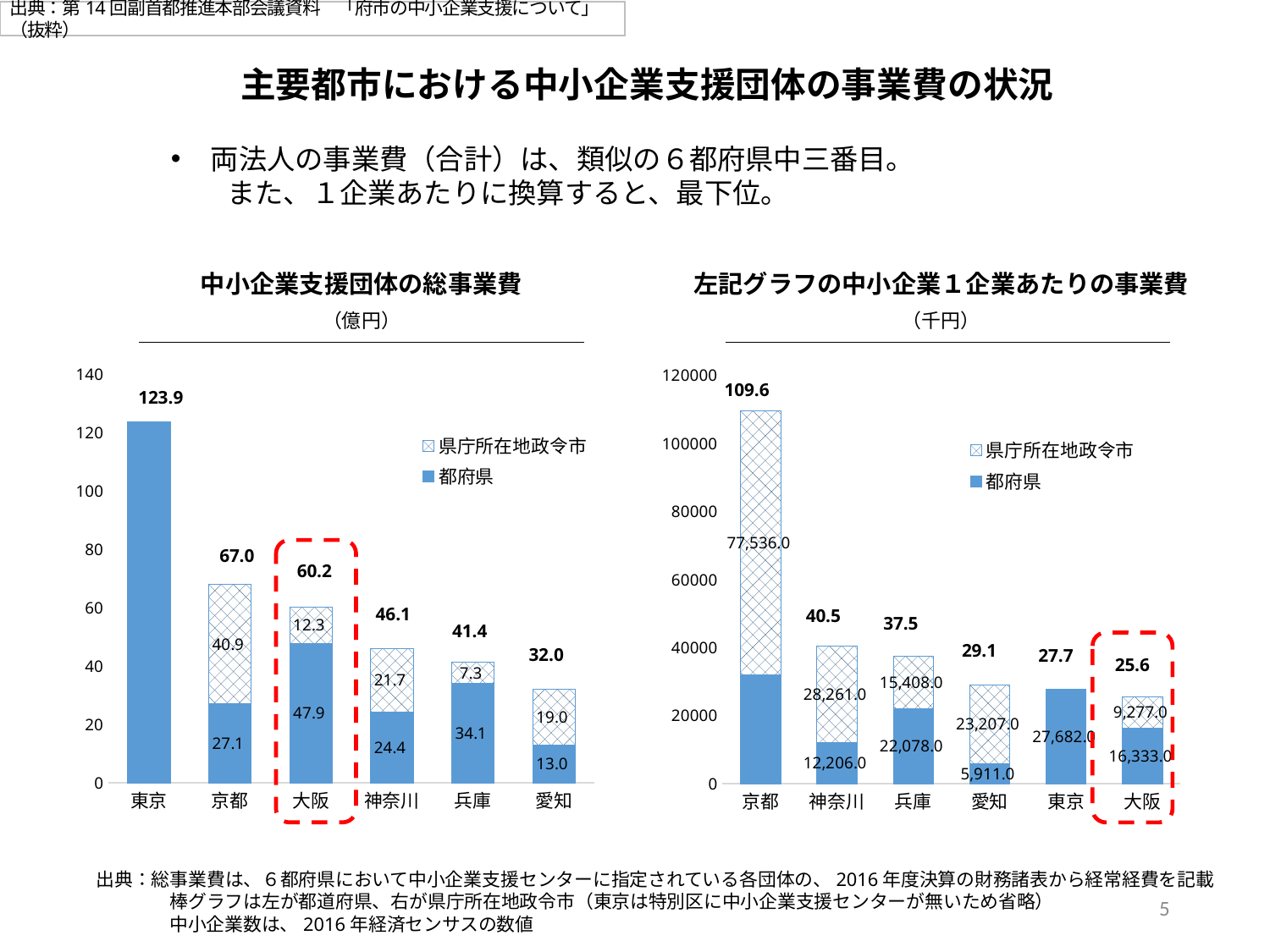
In the left chart (中小企業支援団体の総事業費), what is the difference between the totals for 京都 and 大阪? 6.8 In the left chart (中小企業支援団体の総事業費), what is the total value labeled for 東京? 123.9 In the right chart (左記グラフの中小企業１企業あたりの事業費), what is the 県庁所在地政令市 value for 京都? 77,536.0 In the left chart (中小企業支援団体の総事業費), which category has the lowest total? 愛知 In the left chart (中小企業支援団体の総事業費), what is the 県庁所在地政令市 value for 京都? 40.9 In the left chart (中小企業支援団体の総事業費), how many categories are shown on the x axis? 6 In the right chart (左記グラフの中小企業１企業あたりの事業費), how many series does the legend list? 2 In the right chart (左記グラフの中小企業１企業あたりの事業費), what is the 都府県 value for 愛知? 5,911.0 In the right chart (左記グラフの中小企業１企業あたりの事業費), which is larger, the 都府県 value for 東京 or the 都府県 value for 大阪? 東京 In the left chart (中小企業支援団体の総事業費), what kind of chart is it? Stacked bar chart In the left chart (中小企業支援団体の総事業費), what is the 都府県 value for 大阪? 47.9 In the right chart (左記グラフの中小企業１企業あたりの事業費), which category has the highest total? 京都